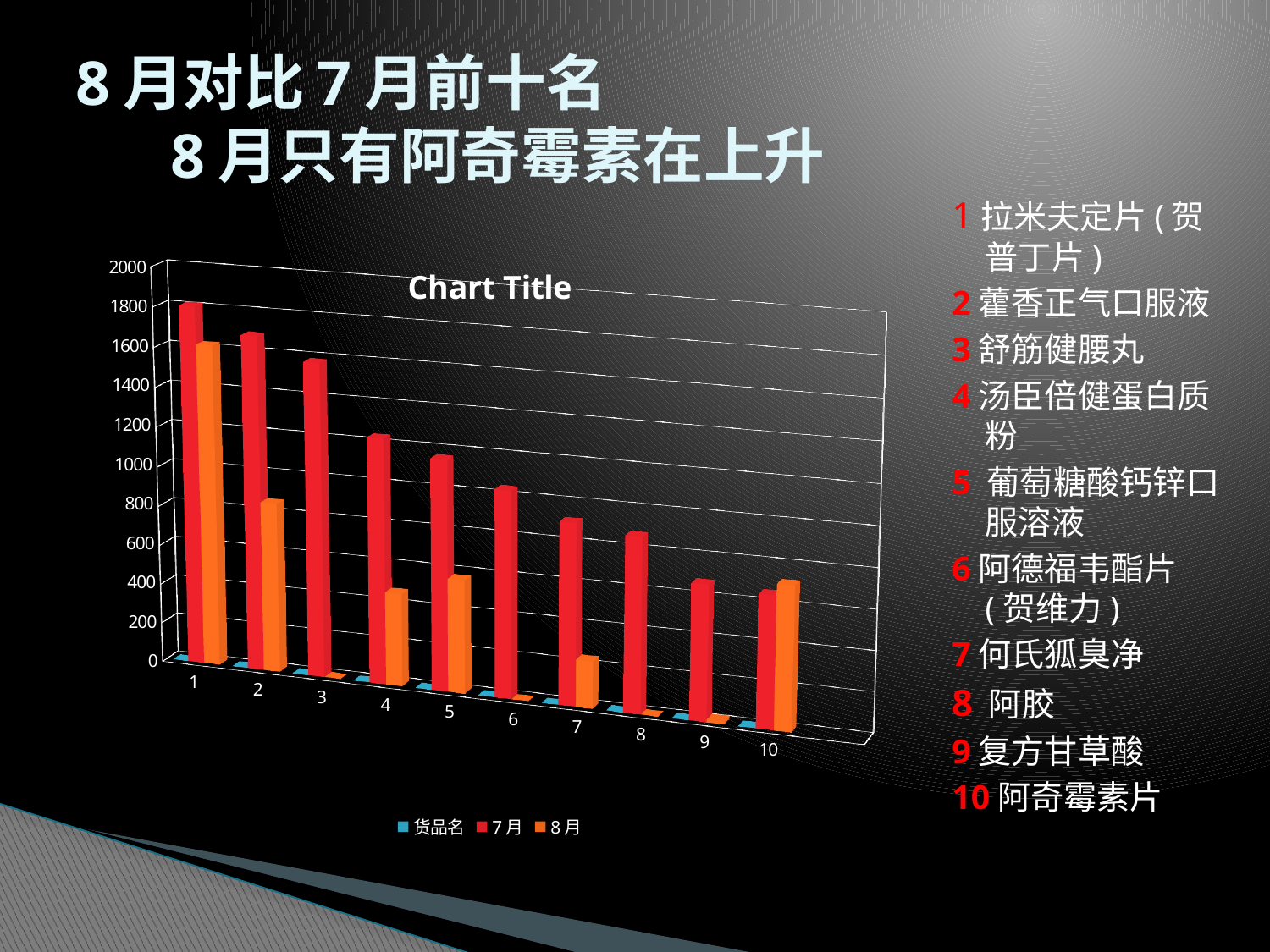
What are the series names listed in the chart legend? 货品名, 7月, 8月 Which category has the highest value for the 8月 series? 1 For category 2, which series has the larger value, 7月 or 8月? 7月 How many series does the chart legend list? 3 Which category has the highest value for the 7月 series? 1 What is the title printed on the chart? Chart Title Is the 8月 value for category 2 greater or less than 1000? less How many categories are shown on the x axis of the chart? 10 Do the 7月 values rise or fall from category 1 to category 10? fall Is the 7月 value for category 5 greater or less than 800? greater Is the 7月 value for category 1 greater or less than 1600? greater What kind of chart is shown on the slide? bar chart